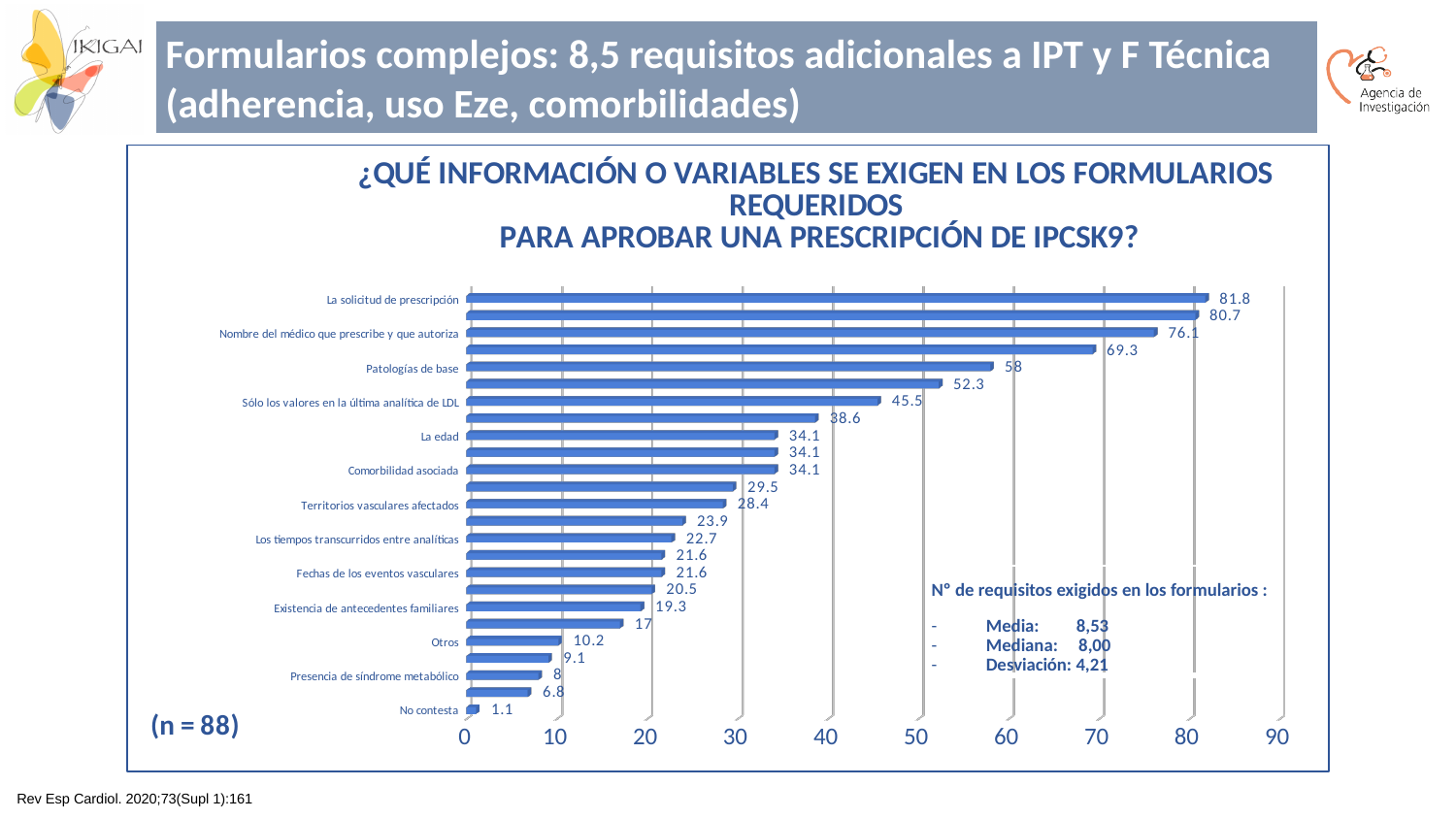
Which is larger, the value for 'Territorios vasculares afectados' or the value for 'Existencia de antecedentes familiares'? Territorios vasculares afectados What is the value for 'No contesta'? 1.1 What is the value for 'La solicitud de prescripción'? 81.8 How many bars are plotted in the chart? 25 What is the value for 'Otros'? 10.2 Which category has the lowest value? No contesta What type of chart is shown on the slide? bar chart What is the difference between the values for 'Patologías de base' and 'Sólo los valores en la última analítica de LDL'? 12.5 Is the value for 'Nombre del médico que prescribe y que autoriza' greater or less than 70? greater What is the value for 'Sólo los valores en la última analítica de LDL'? 45.5 Which category has the highest value? La solicitud de prescripción What is the value for 'Patologías de base'? 58